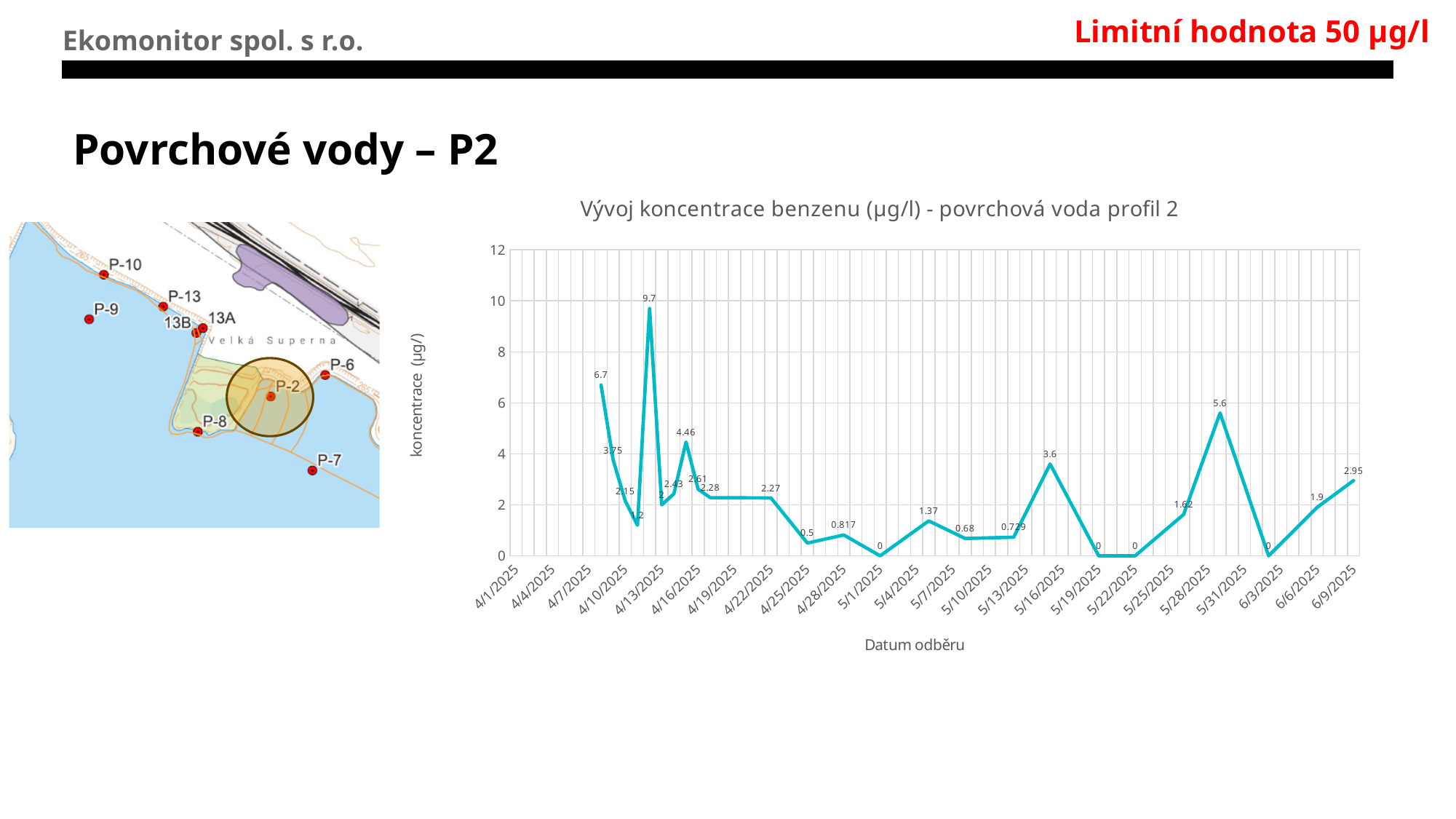
What kind of chart is shown on the slide? line chart What is the difference between the highest value (9.7) and the first value (6.7)? 3 What is the label of the y axis? koncentrace (µg/l) What is the highest benzene concentration value plotted on the chart? 9.7 Is the peak value on the chart greater or less than 8? greater What is the last value plotted on the chart, at 6/9/2025? 2.95 What is the lowest value plotted on the chart? 0 What is the title of the chart? Vývoj koncentrace benzenu (µg/l) - povrchová voda profil 2 How many data points are plotted on the line? 25